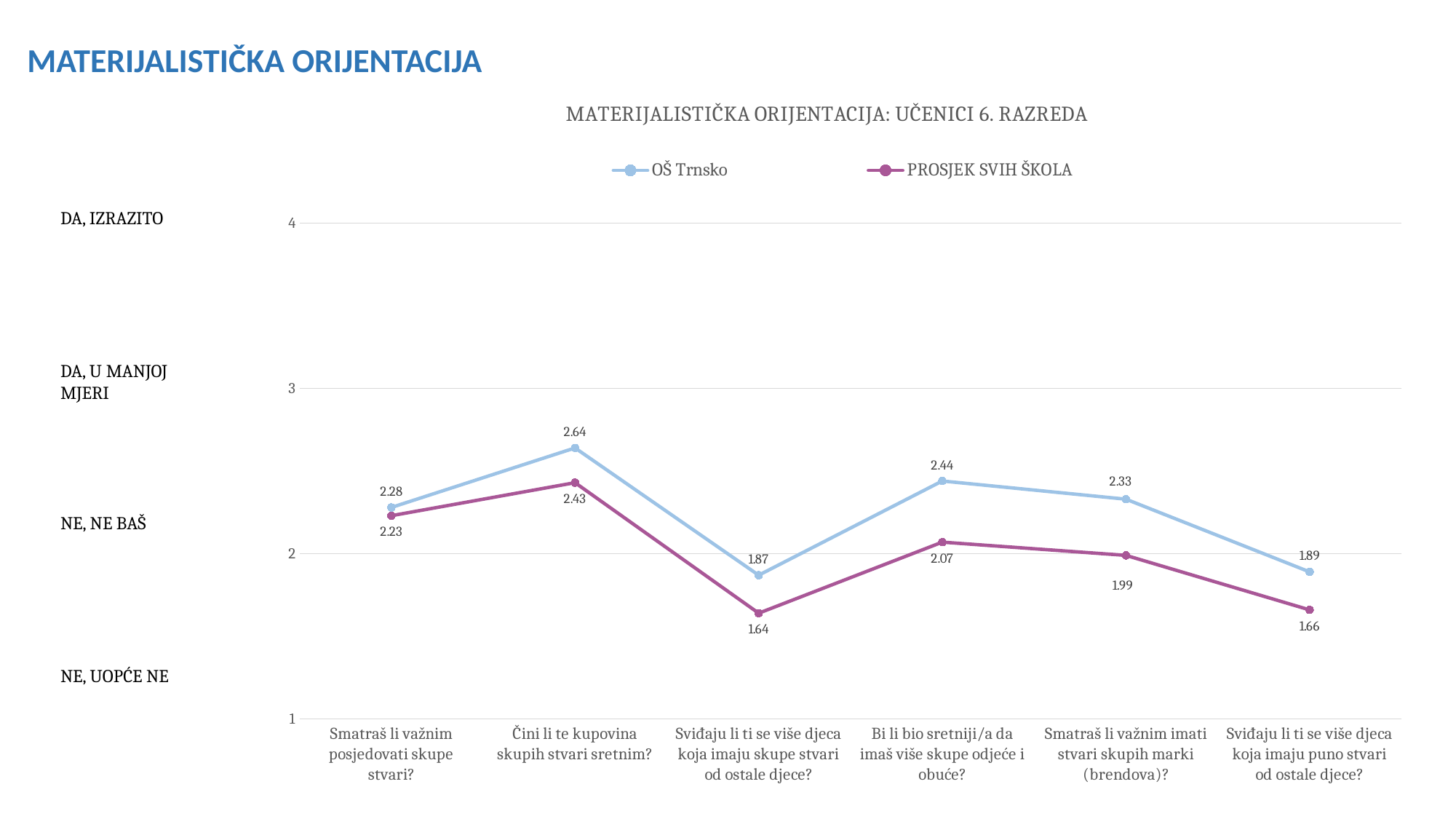
How many categories are shown on the x axis? 6 What is the value for PROSJEK SVIH ŠKOLA on "Sviđaju li ti se više djeca koja imaju skupe stvari od ostale djece?"? 1.64 What is the value for OŠ Trnsko on "Čini li te kupovina skupih stvari sretnim?"? 2.64 What is the title of the chart? MATERIJALISTIČKA ORIJENTACIJA: UČENICI 6. RAZREDA Which category has the highest value for OŠ Trnsko? Čini li te kupovina skupih stvari sretnim? What kind of chart is shown on the slide? line chart Which category has the lowest value for PROSJEK SVIH ŠKOLA? Sviđaju li ti se više djeca koja imaju skupe stvari od ostale djece? What is the difference between OŠ Trnsko and PROSJEK SVIH ŠKOLA on "Bi li bio sretniji/a da imaš više skupe odjeće i obuće?"? 0.37 How many series does the legend list? 2 Which series has the larger value on "Sviđaju li ti se više djeca koja imaju puno stvari od ostale djece?"? OŠ Trnsko What is the value for PROSJEK SVIH ŠKOLA on "Smatraš li važnim imati stvari skupih marki (brendova)?"? 1.99 Is the value for OŠ Trnsko on "Sviđaju li ti se više djeca koja imaju skupe stvari od ostale djece?" greater or less than 2? less